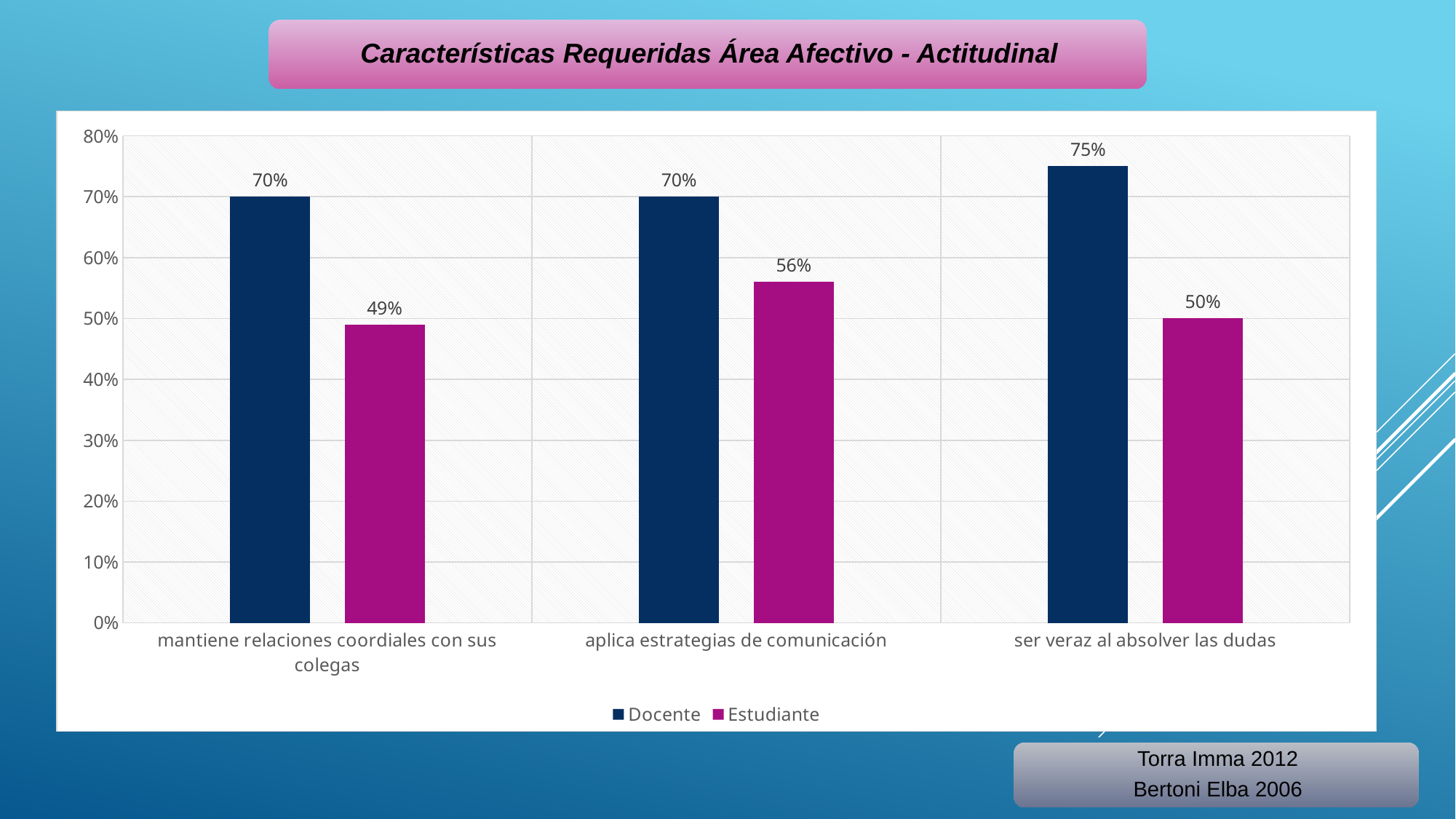
What is the title of the slide? Características Requeridas Área Afectivo - Actitudinal What kind of chart is shown on the slide? bar chart What is the Estudiante value for "aplica estrategias de comunicación"? 56% What is the difference between the Docente and Estudiante values for "ser veraz al absolver las dudas"? 25% How many series does the legend list? 2 Which category has the lowest Estudiante value? mantiene relaciones coordiales con sus colegas What is the Docente value for "ser veraz al absolver las dudas"? 75% Which category has the highest Docente value? ser veraz al absolver las dudas Which is larger for "aplica estrategias de comunicación": the Docente value or the Estudiante value? Docente How many categories are shown on the x axis? 3 What is the difference between the Docente and Estudiante values for "mantiene relaciones coordiales con sus colegas"? 21% What is the Estudiante value for "mantiene relaciones coordiales con sus colegas"? 49%